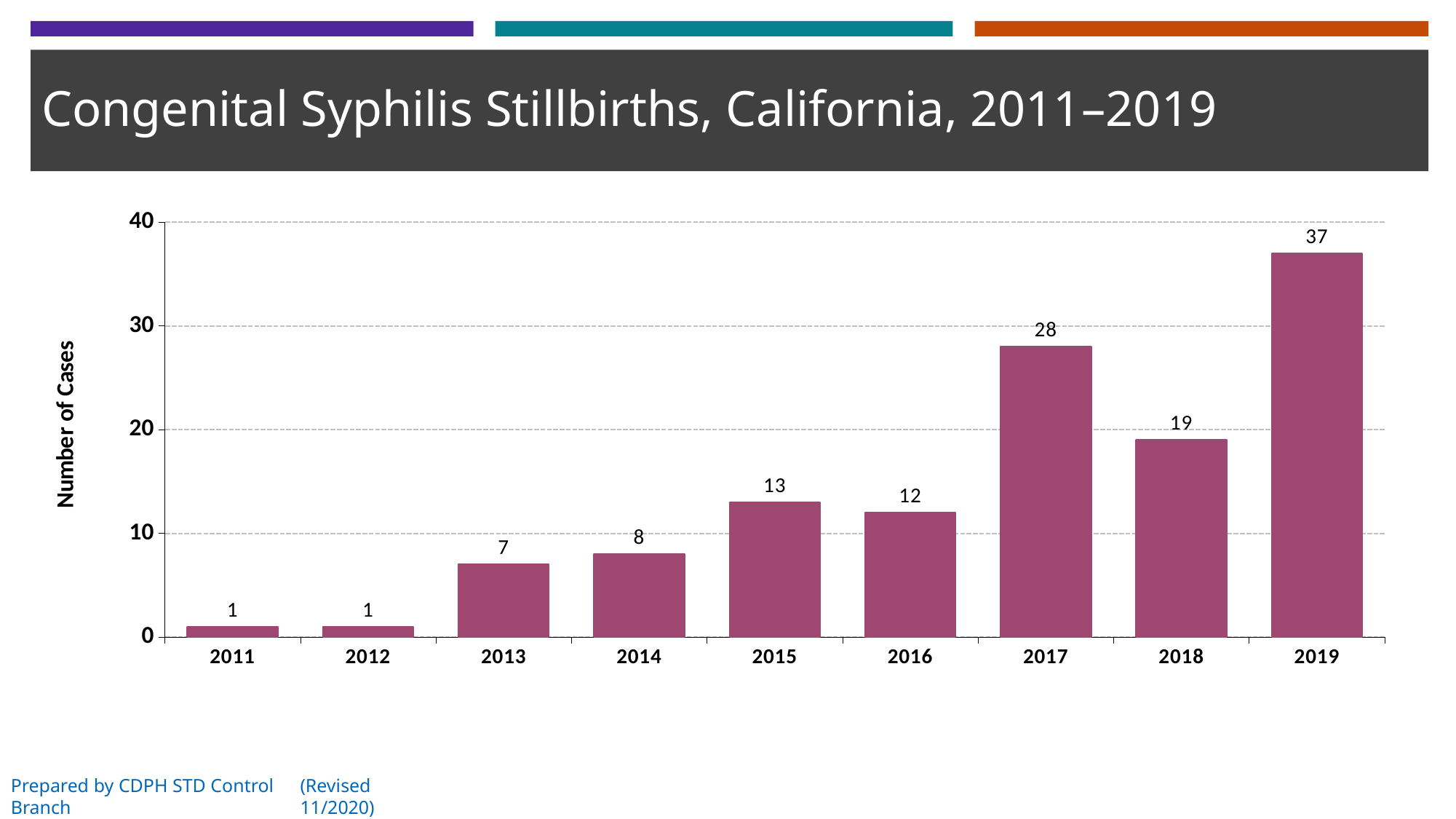
Which year has the highest number of cases? 2019 What is the label of the y axis? Number of Cases What is the difference in the number of cases between 2019 and 2018? 18 What kind of chart is shown on the slide? bar chart Is the value for 2018 greater or less than 20? less What is the number of cases in 2014? 8 What is the number of cases in 2017? 28 What is the difference in the number of cases between 2017 and 2016? 16 Do the values generally rise or fall from 2011 to 2019? rise Which year has more cases, 2015 or 2016? 2015 Which years have the lowest number of cases? 2011 and 2012 How many years are shown on the x axis? 9